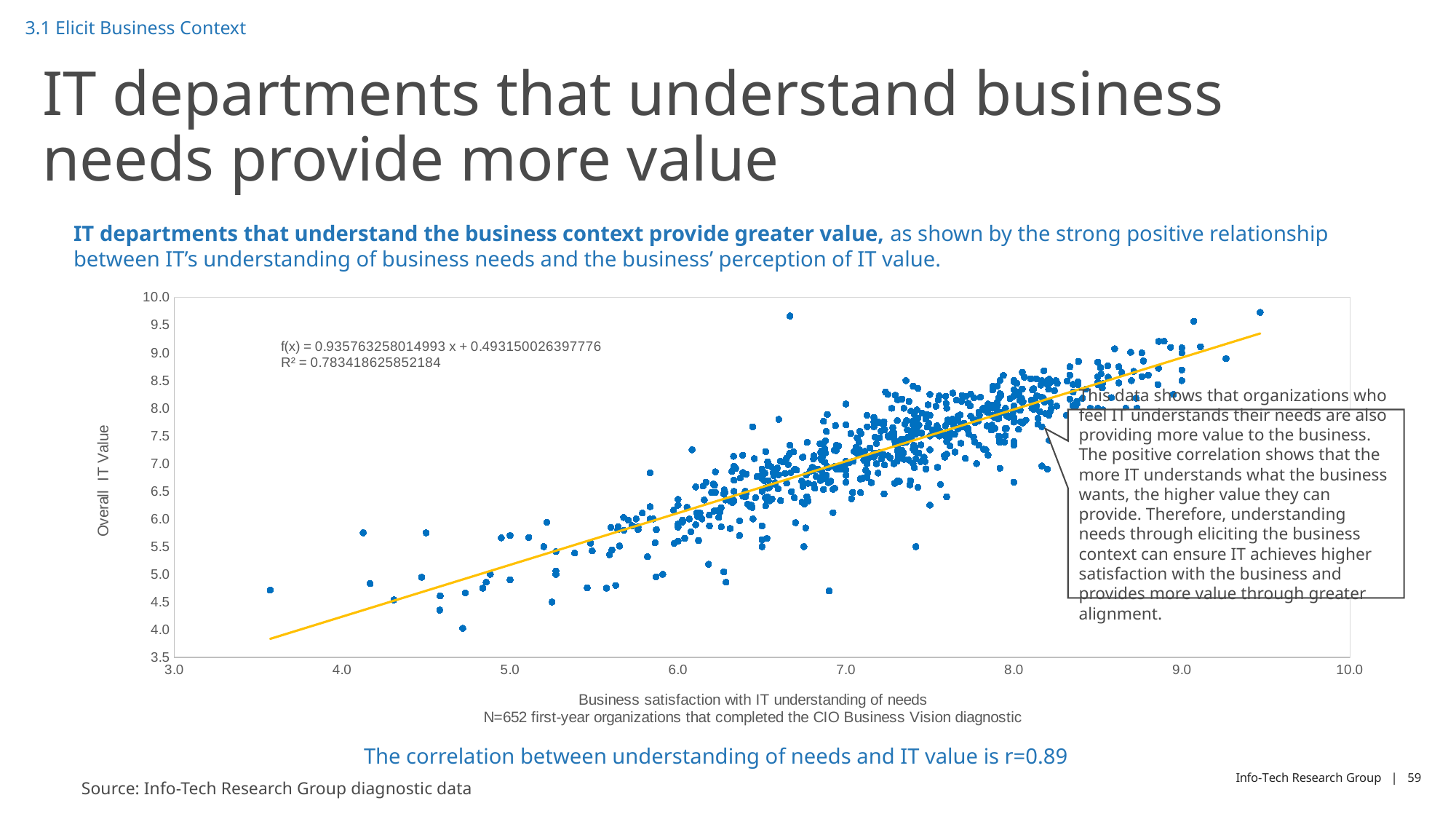
Is the Overall IT Value of the lowest plotted point greater or less than 4.5? less Is the Overall IT Value of the highest plotted point greater or less than 9.0? greater What is the maximum value shown on the y axis of the chart? 10.0 What is the minimum value shown on the x axis of the chart? 3.0 What is the R² value printed on the chart? 0.783418625852184 What is the intercept of the trendline equation printed on the chart? 0.493150026397776 What is the slope of the trendline equation printed on the chart? 0.935763258014993 What kind of chart is shown on the slide? Scatter chart How many first-year organizations are included in the data plotted on the chart? 652 Is the Overall IT Value of the leftmost plotted point greater or less than 5.0? less Do the plotted values of Overall IT Value rise or fall as Business satisfaction with IT understanding of needs increases along the x axis? Rise What is the label of the x axis of the chart? Business satisfaction with IT understanding of needs